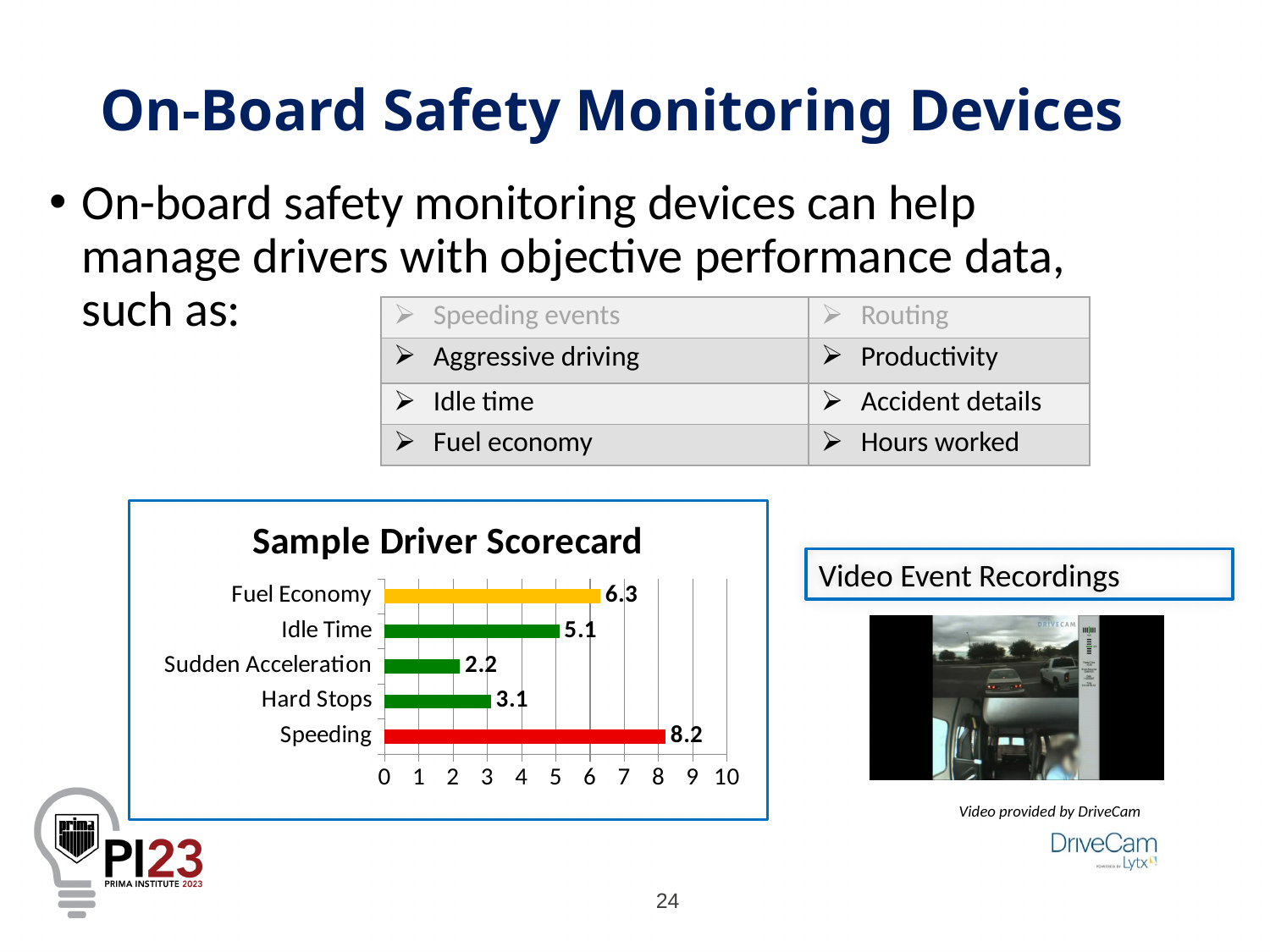
What kind of chart is the Sample Driver Scorecard? Bar chart Is the value for Sudden Acceleration on the Sample Driver Scorecard chart greater or less than 3? less Which category has the highest value on the Sample Driver Scorecard chart? Speeding Which is larger on the Sample Driver Scorecard chart, Idle Time or Hard Stops? Idle Time What is the value for Idle Time on the Sample Driver Scorecard chart? 5.1 What is the value for Hard Stops on the Sample Driver Scorecard chart? 3.1 What is the value for Speeding on the Sample Driver Scorecard chart? 8.2 Which category has the lowest value on the Sample Driver Scorecard chart? Sudden Acceleration What colour is the Speeding bar on the Sample Driver Scorecard chart? Red What is the value for Fuel Economy on the Sample Driver Scorecard chart? 6.3 How many categories are shown on the Sample Driver Scorecard chart? 5 What is the difference between the Speeding and Fuel Economy values on the Sample Driver Scorecard chart? 1.9